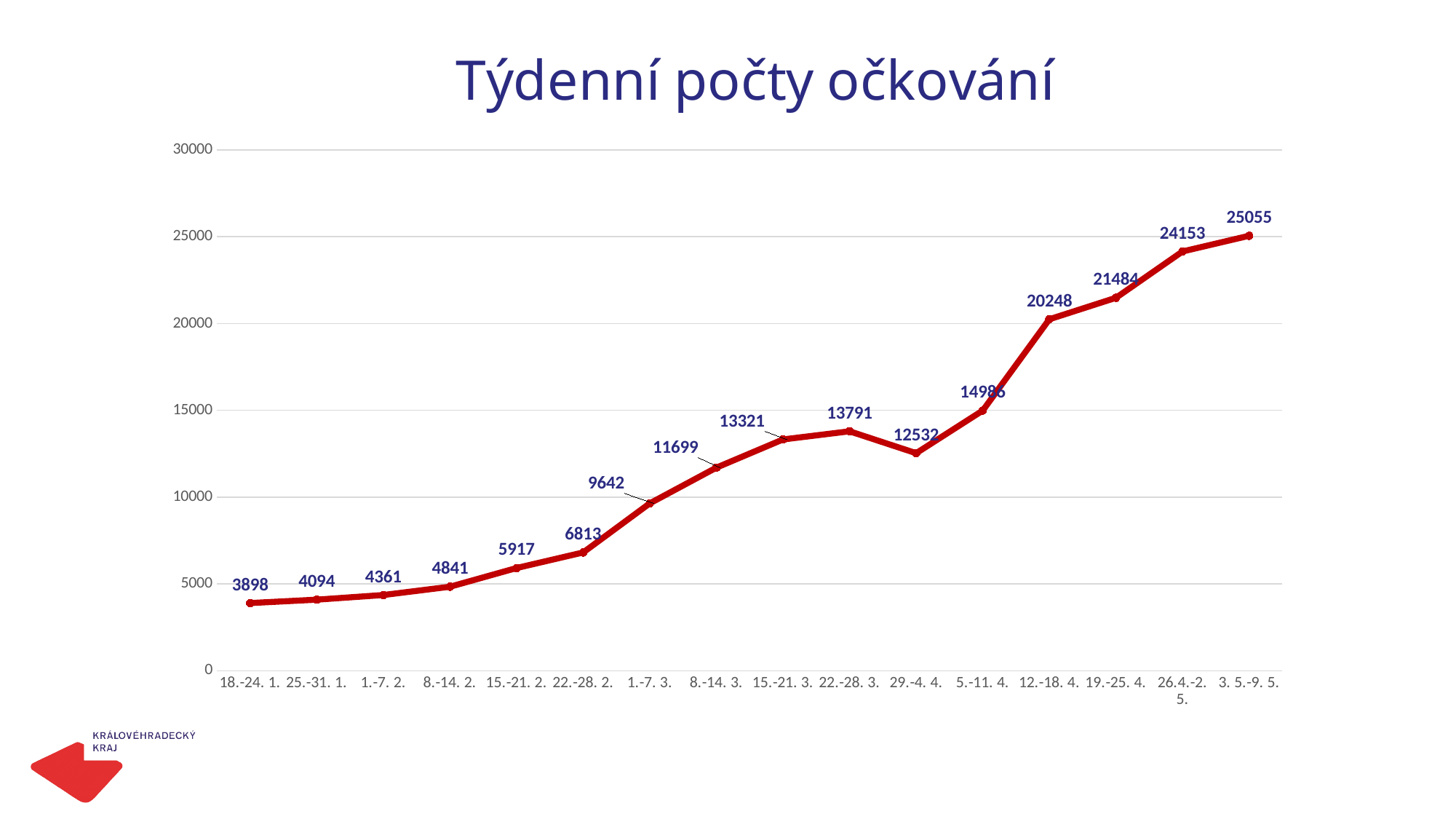
Which week has the lowest value? 18.-24. 1. How many weeks (data points) are plotted on the chart? 16 What is the value for the week 18.-24. 1.? 3898 Which week has the highest value? 3. 5.-9. 5. Which is larger, the value for 22.-28. 3. or the value for 29.-4. 4.? 22.-28. 3. What type of chart is shown on the slide? line chart What is the difference between the values for 22.-28. 3. and 29.-4. 4.? 1259 What is the difference between the values for 3. 5.-9. 5. and 26.4.-2. 5.? 902 What is the value for the week 12.-18. 4.? 20248 What is the value for the week 1.-7. 3.? 9642 Do the values generally rise or fall from left to right along the x axis? rise What is the title of the chart? Týdenní počty očkování